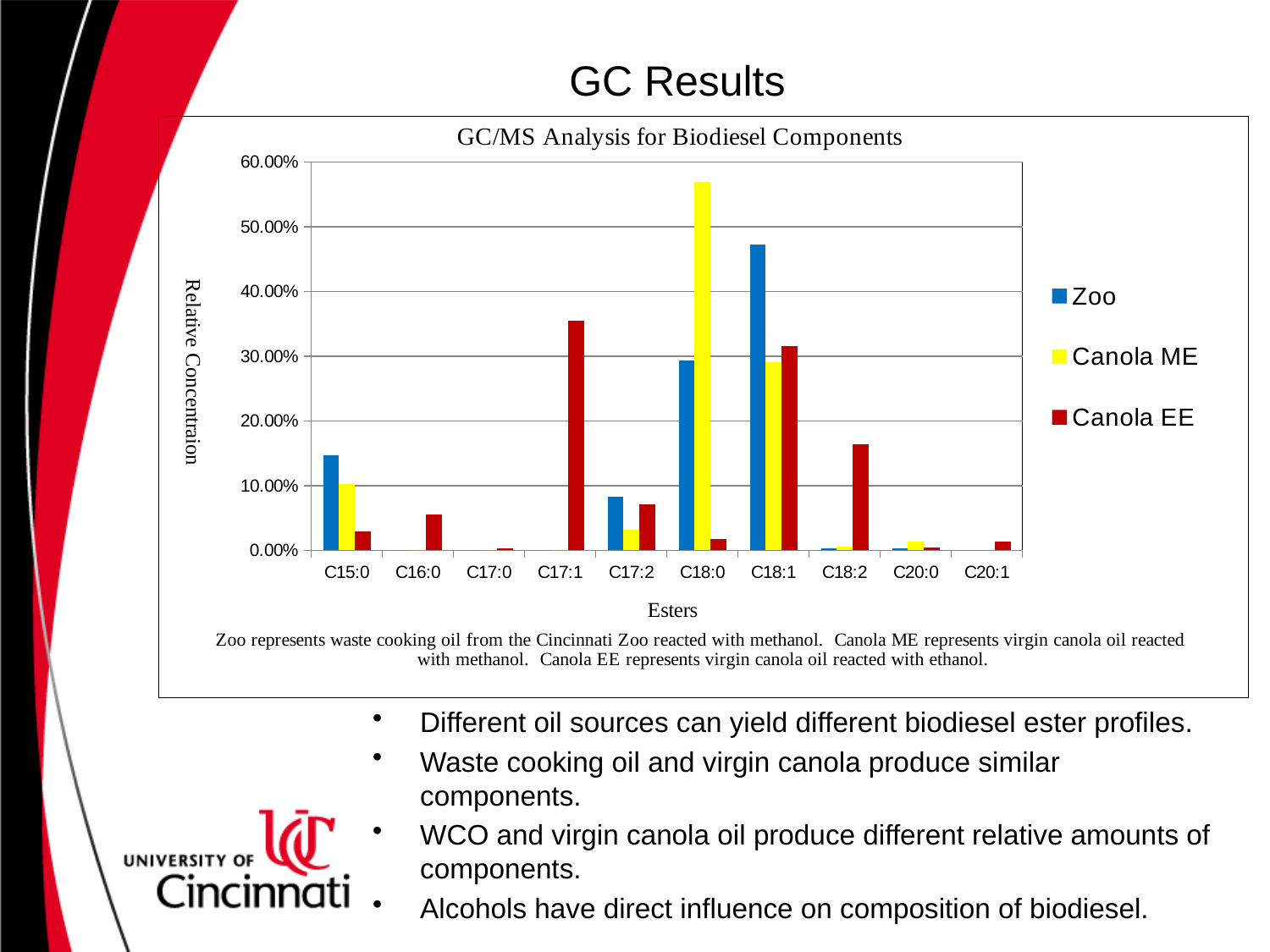
How many ester categories are shown on the x axis? 10 What type of chart is shown on the slide? bar chart At C15:0, which is larger: the Zoo value or the Canola EE value? Zoo For which ester is the Zoo value highest? C18:1 What is the title of the chart? GC/MS Analysis for Biodiesel Components How many series does the legend list? 3 Is the Zoo value for C18:1 greater or less than 40.00%? greater For which ester is the Canola ME value highest? C18:0 At C18:0, which is larger: the Zoo value or the Canola ME value? Canola ME Is the Canola ME value for C18:0 greater or less than 50.00%? greater Is the Canola EE value for C17:1 greater or less than 30.00%? greater For which ester is the Canola EE value highest? C17:1